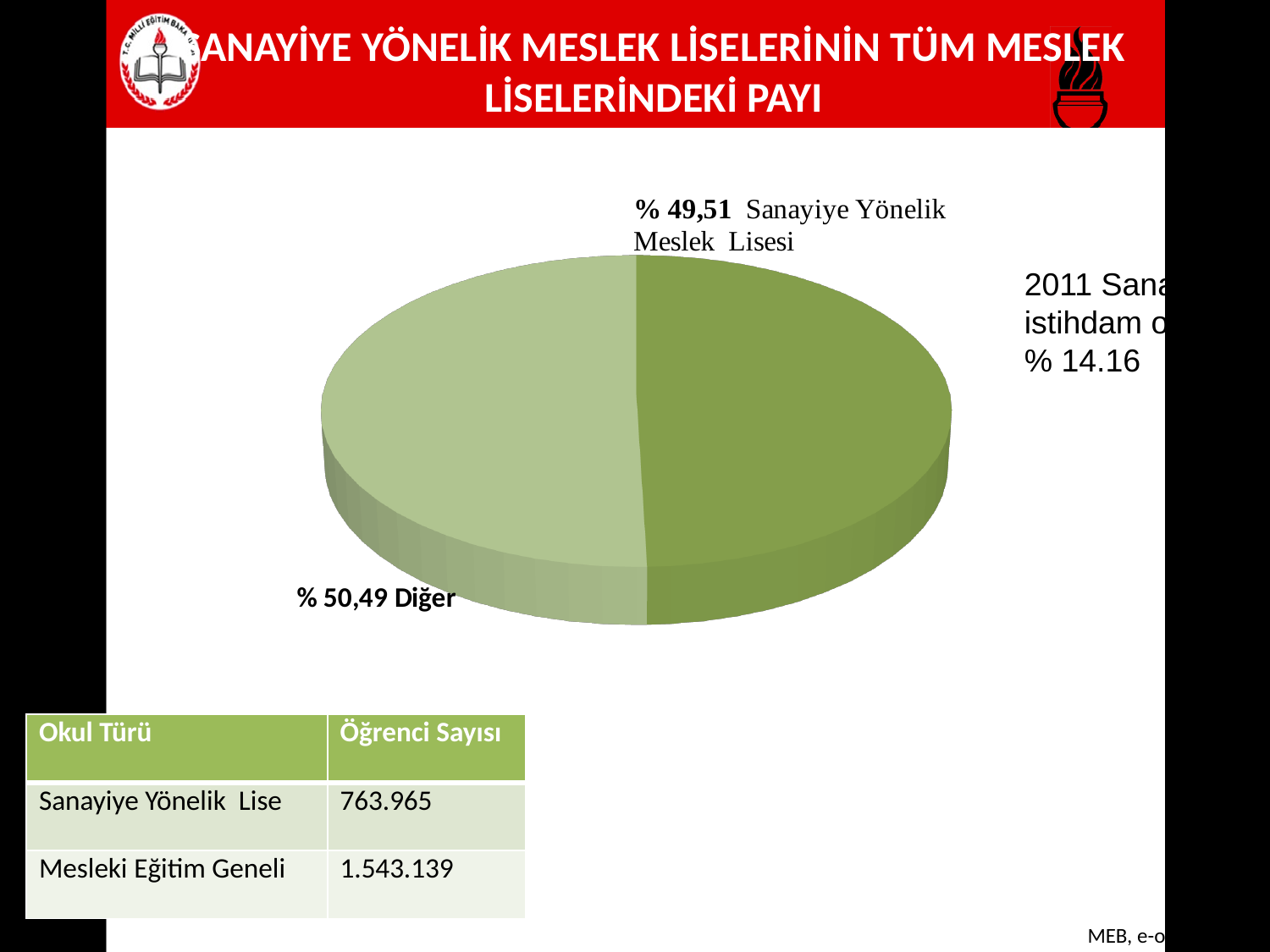
What is the value labelled for the Diğer slice? % 50,49 Which slice of the pie chart is drawn in the lighter green colour? Diğer What is the difference in percentage points between the Diğer slice and the Sanayiye Yönelik Meslek Lisesi slice? 0,98 What kind of chart is shown on the slide? pie chart What is the value labelled for the Sanayiye Yönelik Meslek Lisesi slice? % 49,51 How many slices does the pie chart have? 2 What share of the pie does the Sanayiye Yönelik Meslek Lisesi slice represent? % 49,51 Which slice of the pie chart is drawn in the darker green colour? Sanayiye Yönelik Meslek Lisesi What share of the pie does the Diğer slice represent? % 50,49 Which slice of the pie chart is the smallest? Sanayiye Yönelik Meslek Lisesi Which slice of the pie chart is the largest? Diğer Which is larger, the Diğer slice or the Sanayiye Yönelik Meslek Lisesi slice? Diğer